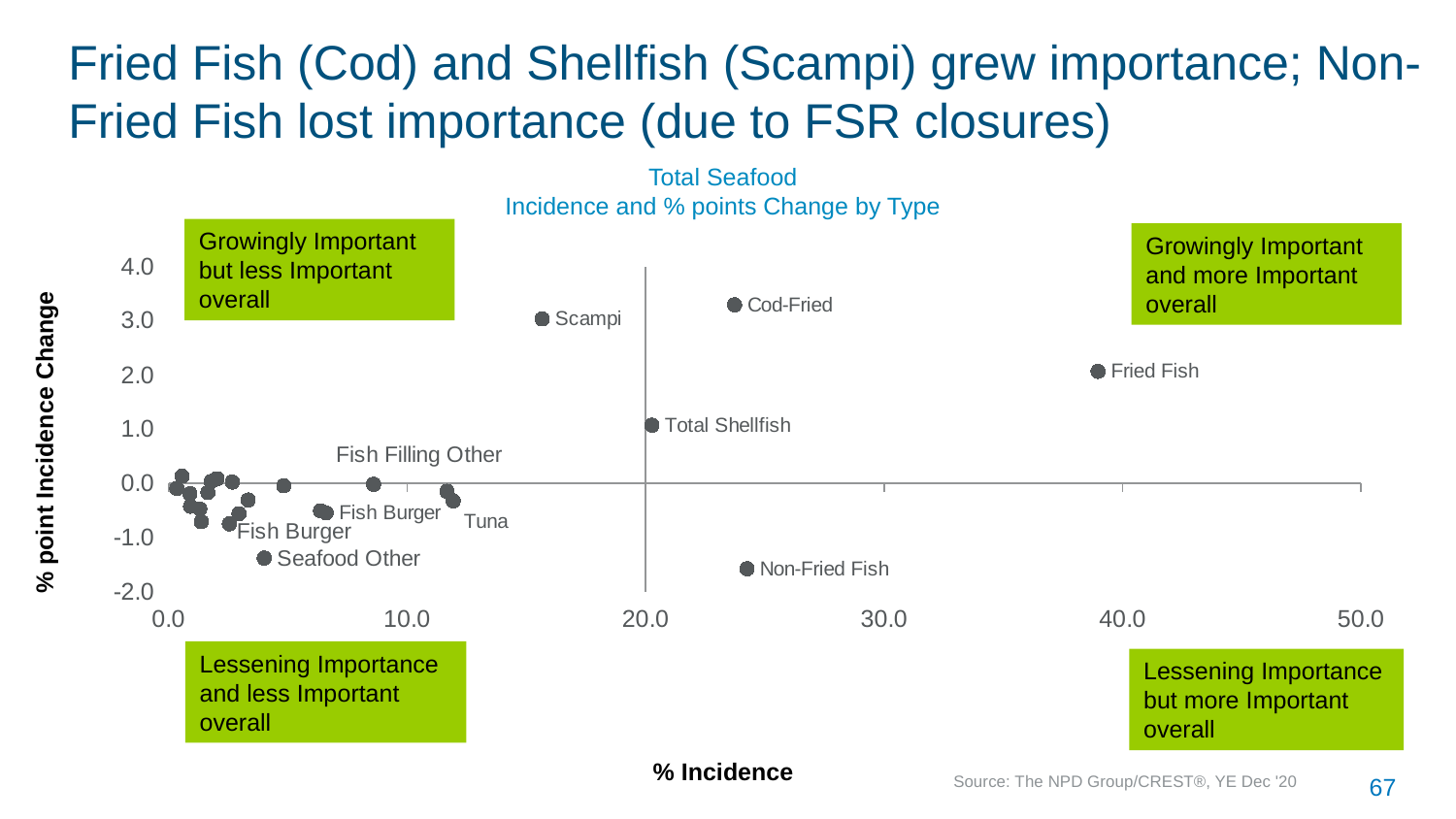
Which has a higher % Incidence, Fried Fish or Scampi? Fried Fish Which has a higher % point Incidence Change, Total Shellfish or Non-Fried Fish? Total Shellfish What is the label of the horizontal axis? % Incidence Is the % Incidence for Total Shellfish greater or less than 10.0? greater What kind of chart is shown on the slide? Scatter chart What is the title of the chart? Total Seafood Incidence and % points Change by Type Is the % point Incidence Change for Cod-Fried greater or less than 2.0? greater Is the % Incidence for Scampi greater or less than 20.0? less Which labeled seafood type has the highest % Incidence? Fried Fish Which has a higher % point Incidence Change, Fried Fish or Seafood Other? Fried Fish